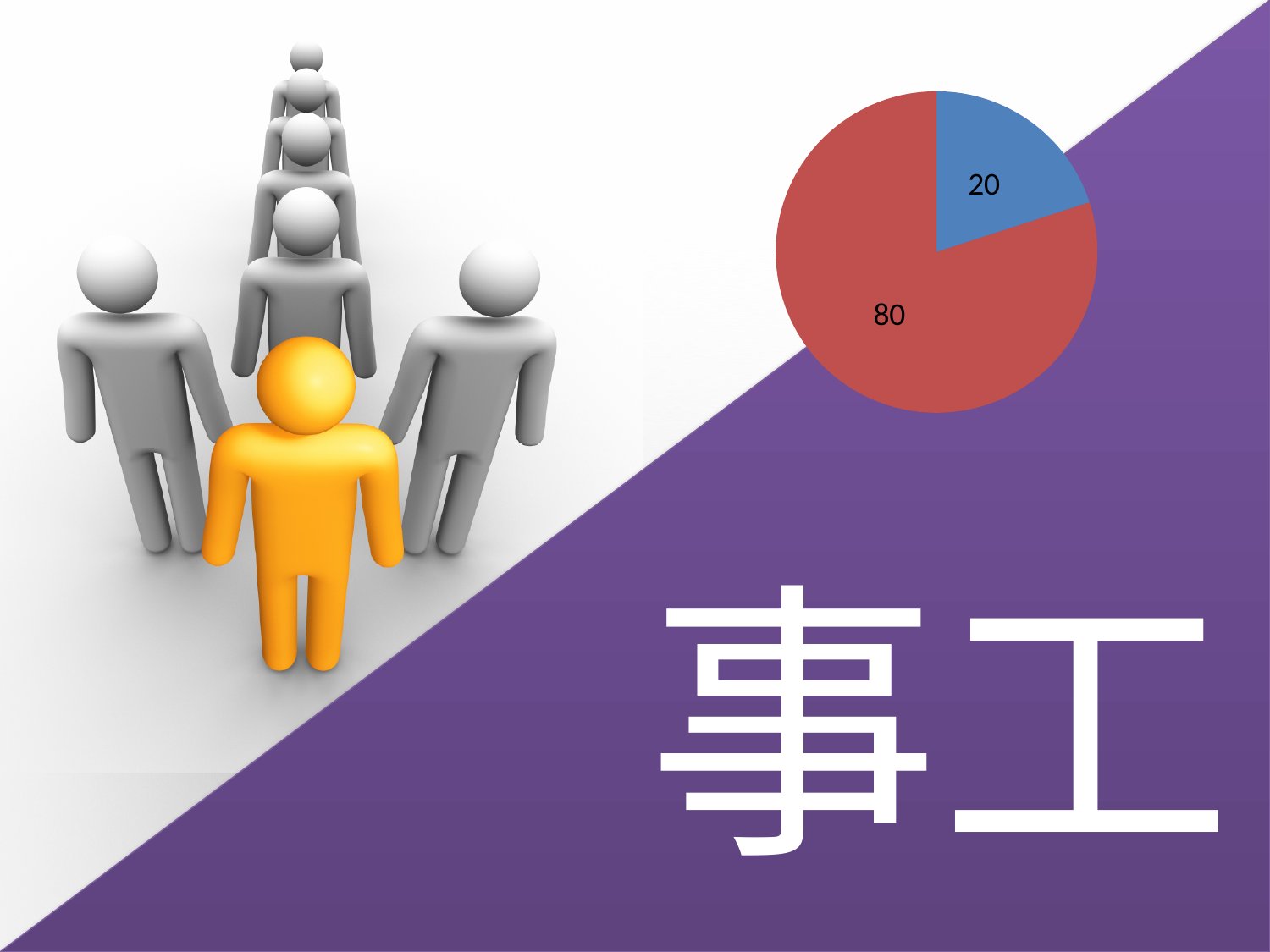
What colour is the slice labelled 20 in the pie chart? blue What share of the pie does the red slice represent? 80% How many slices does the pie chart have? 2 What value is labelled on the red slice of the pie chart? 80 What is the total of the two values shown in the pie chart? 100 What value is labelled on the blue slice of the pie chart? 20 What is the difference between the red slice's value and the blue slice's value? 60 What kind of chart is shown on the slide? pie chart What share of the pie does the blue slice represent? 20% Which is larger, the red slice or the blue slice? the red slice Which slice of the pie chart is the smallest? the blue slice (20) Which slice of the pie chart is the largest? the red slice (80)